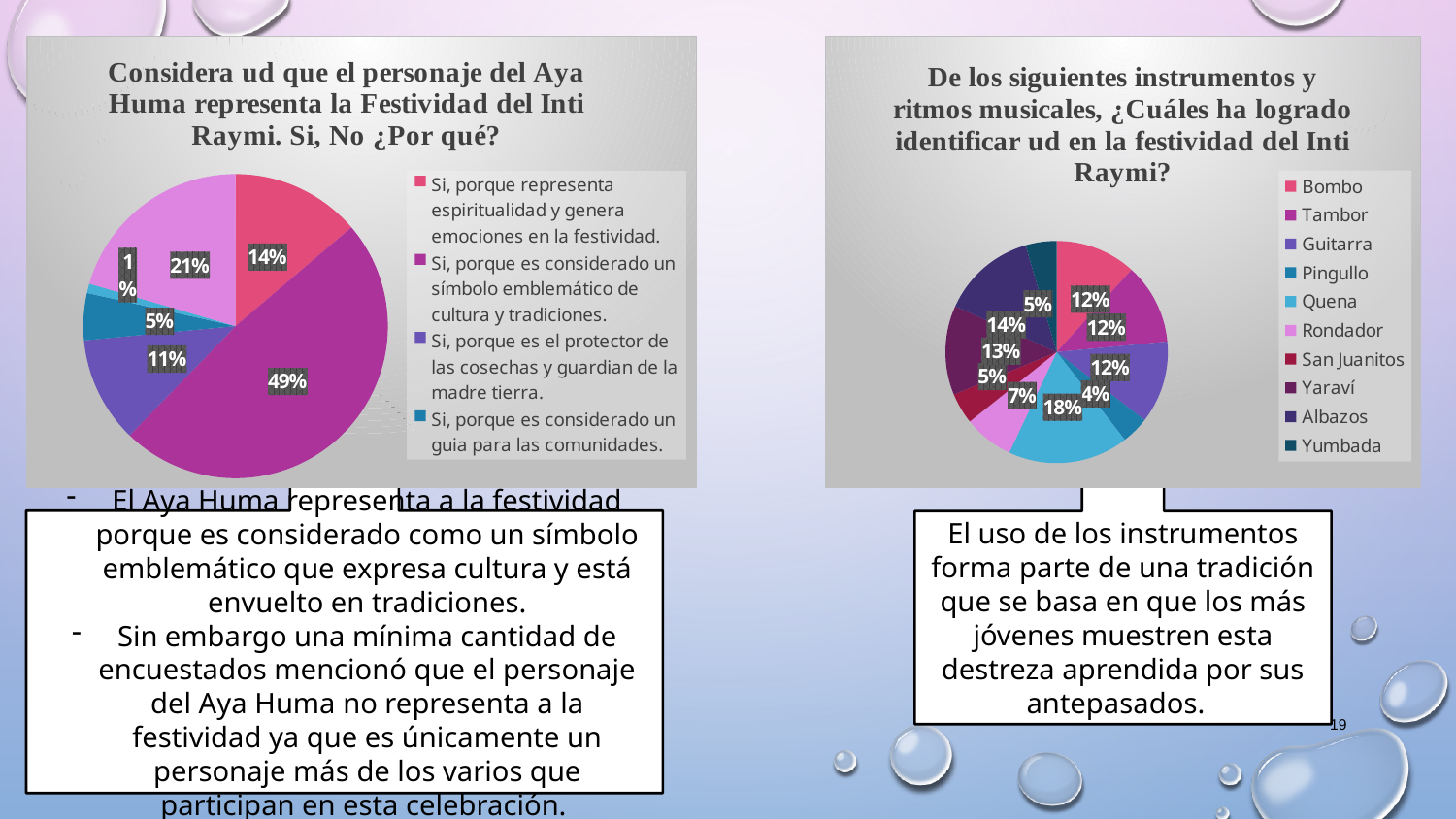
In the right chart (instrumentos y ritmos musicales), what percentage is shown for Bombo? 12% In the right chart (instrumentos y ritmos musicales), what percentage is shown for Quena? 18% How many slices does the left chart (Aya Huma) have? 6 In the left chart (Aya Huma), what is the largest percentage shown? 49% In the left chart (Aya Huma), what share corresponds to 'Si, porque es el protector de las cosechas y guardian de la madre tierra'? 11% In the right chart (instrumentos y ritmos musicales), what is the difference in percentage points between Quena and Pingullo? 14 How many entries does the legend of the right chart (instrumentos y ritmos musicales) list? 10 In the right chart (instrumentos y ritmos musicales), which instrument has the largest share? Quena In the left chart (Aya Huma), what share corresponds to 'Si, porque representa espiritualidad y genera emociones en la festividad'? 14% What type of chart is the left chart about the Aya Huma? Pie chart In the right chart (instrumentos y ritmos musicales), which instrument has the smallest share? Pingullo In the left chart (Aya Huma), what share corresponds to 'Si, porque es considerado un símbolo emblemático de cultura y tradiciones'? 49%